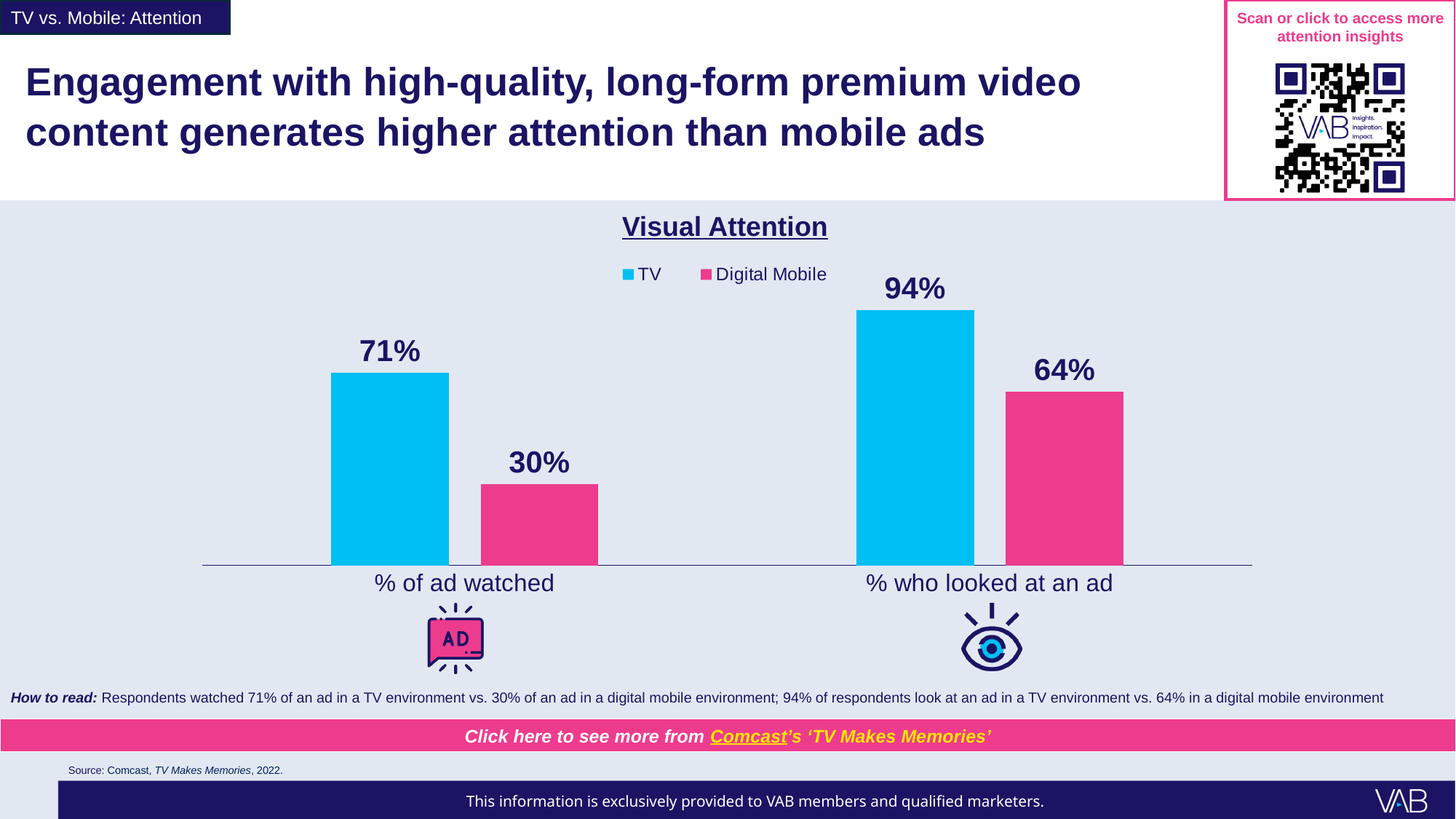
What is the TV value for '% of ad watched'? 71% Which is larger for '% who looked at an ad': TV or Digital Mobile? TV What is the TV value for '% who looked at an ad'? 94% What is the difference between the TV and Digital Mobile values for '% who looked at an ad'? 30 percentage points Which bar has the highest value in the chart? TV, % who looked at an ad How many series does the legend list? 2 What is the Digital Mobile value for '% who looked at an ad'? 64% Which bar has the lowest value in the chart? Digital Mobile, % of ad watched What is the Digital Mobile value for '% of ad watched'? 30% What is the title of the chart? Visual Attention How many categories are shown on the x axis? 2 What is the difference between the TV and Digital Mobile values for '% of ad watched'? 41 percentage points